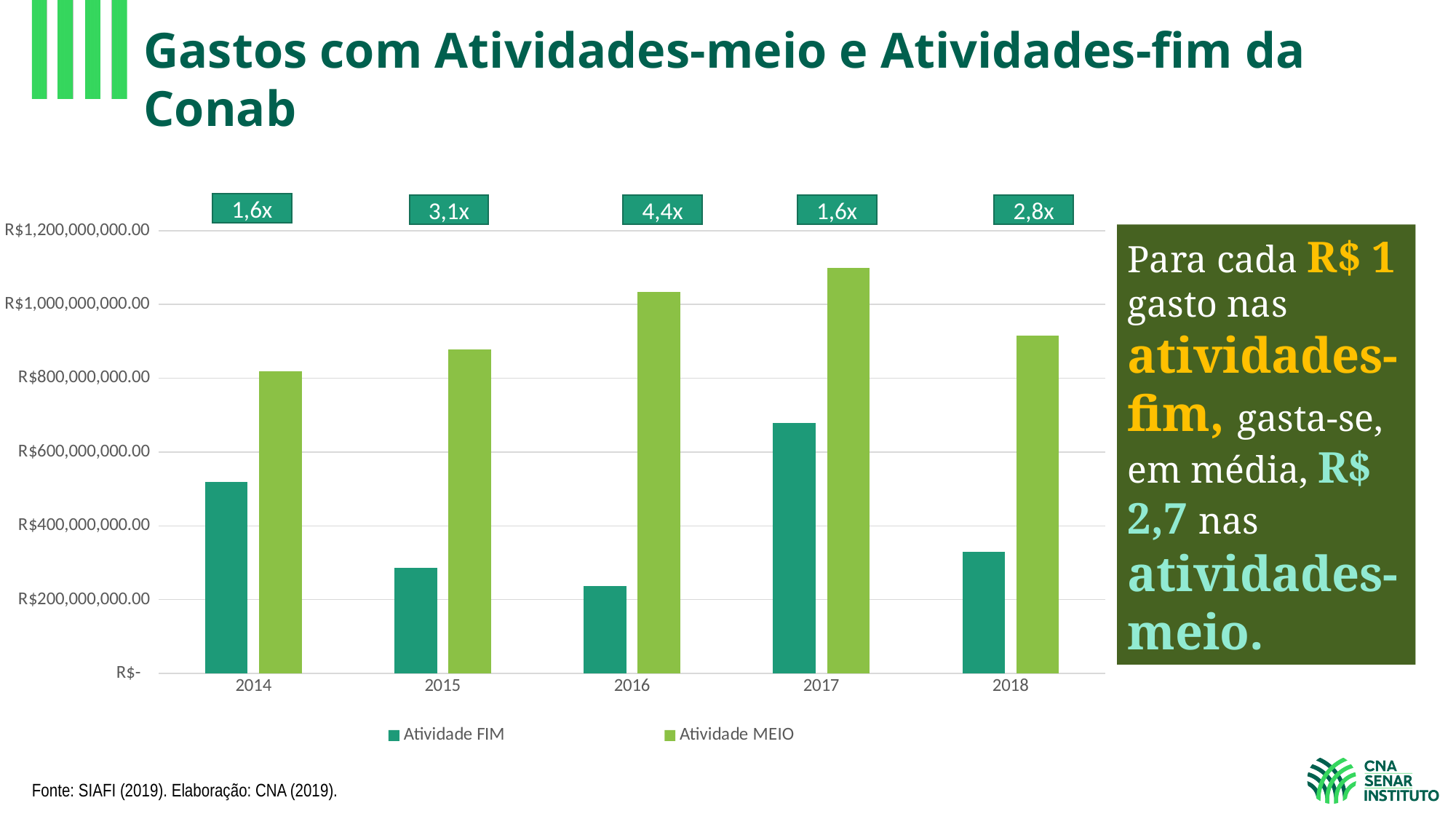
Which is larger in 2014, the Atividade FIM bar or the Atividade MEIO bar? Atividade MEIO What are the two series named in the chart legend? Atividade FIM and Atividade MEIO What kind of chart is shown on the slide? bar chart Is the Atividade MEIO value for 2016 greater or less than R$1,000,000,000.00? greater What ratio label is printed above the bars for 2018? 2,8x In which year is the Atividade FIM bar the lowest? 2016 How many years are shown on the x axis of the chart? 5 How many series does the chart legend list? 2 In which year is the Atividade MEIO bar the highest? 2017 What ratio label is printed above the bars for 2016? 4,4x In which year is the Atividade FIM bar the highest? 2017 Is the Atividade FIM value for 2015 greater or less than R$400,000,000.00? less